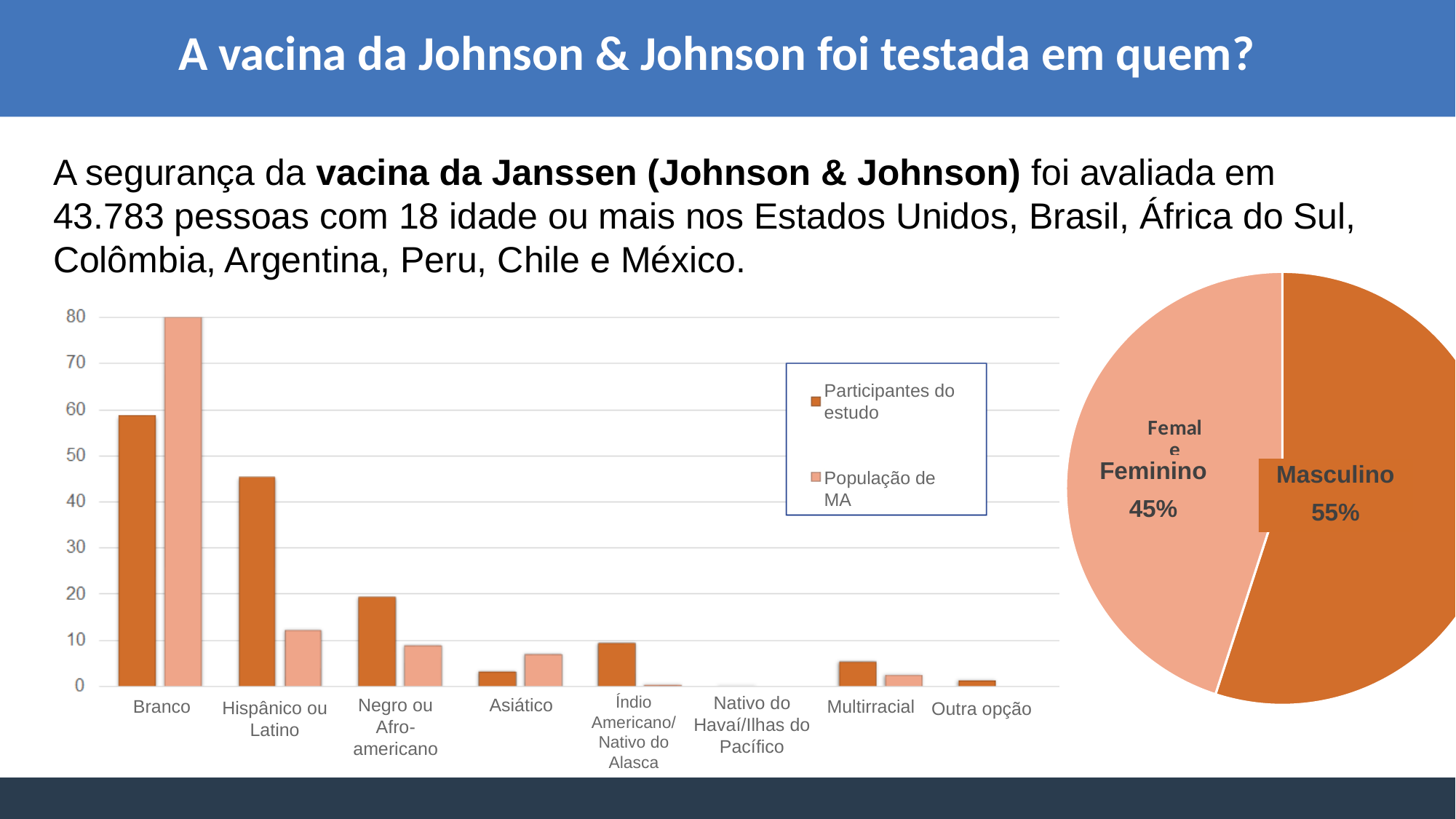
In the bar chart on the left, how many categories are shown on the x axis? 8 In the bar chart on the left, is the value for Participantes do estudo for Asiático greater or less than 10? less In the bar chart on the left, how many series does the legend list? 2 What kind of chart is the chart on the left of the slide? bar chart In the bar chart on the left, is the value for Participantes do estudo for Branco greater or less than 50? greater In the pie chart on the right, what is the difference between the Masculino and Feminino shares? 10% In the bar chart on the left, which category has the highest value for Participantes do estudo? Branco In the bar chart on the left, for Branco, which series has the larger value: Participantes do estudo or População de MA? População de MA In the bar chart on the left, which category has the highest value for População de MA? Branco What kind of chart is the chart on the right of the slide? pie chart In the pie chart on the right, what share is Masculino? 55% In the bar chart on the left, for Hispânico ou Latino, which series has the larger value: Participantes do estudo or População de MA? Participantes do estudo